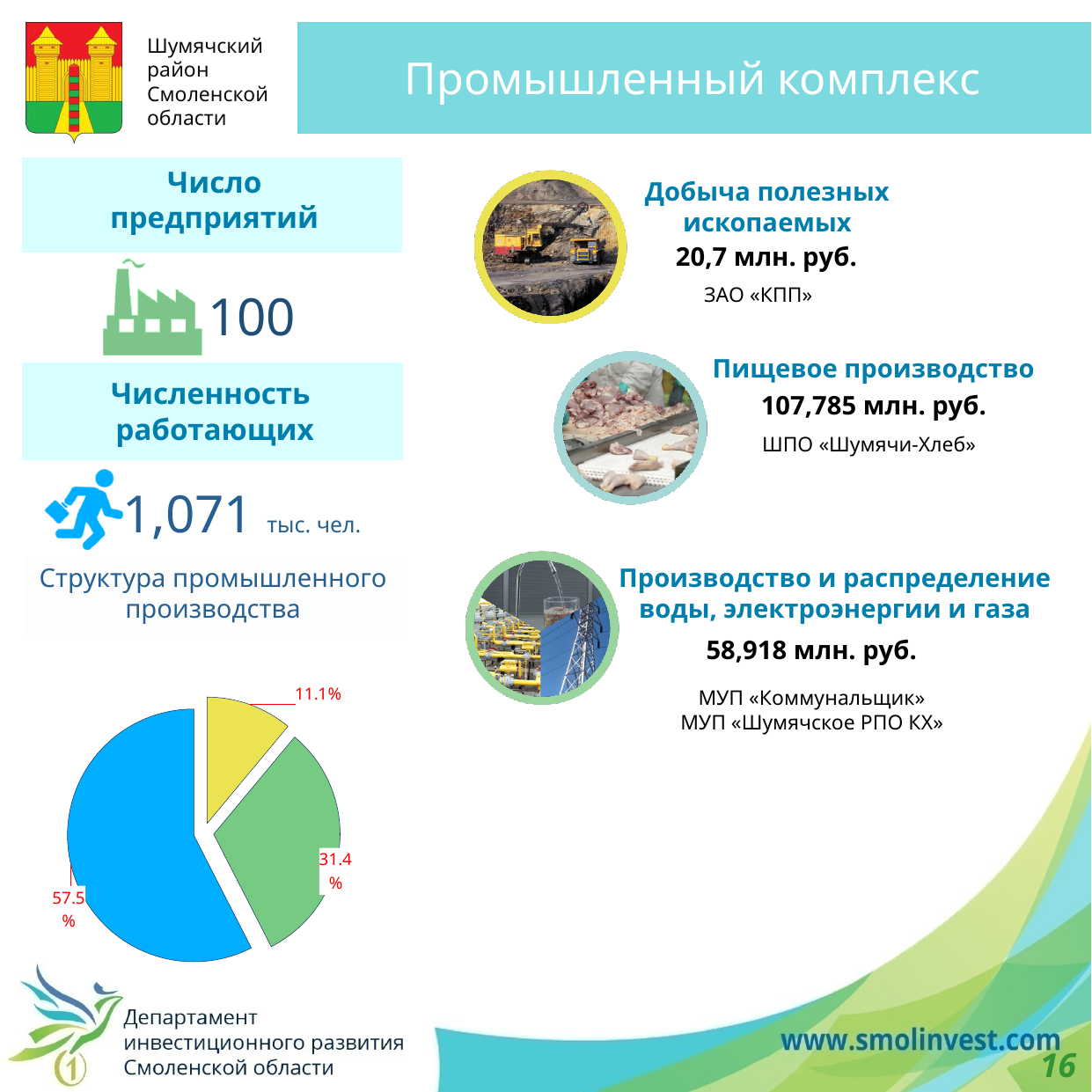
What is the value of the largest slice in the pie chart "Структура промышленного производства"? 57.5% What is the value of the smallest slice in the pie chart "Структура промышленного производства"? 11.1% In the pie chart "Структура промышленного производства", what share does the middle-sized slice represent? 31.4% How many slices does the pie chart "Структура промышленного производства" have? 3 In the pie chart "Структура промышленного производства", is the largest slice greater or less than 50%? greater What colour is the largest slice of the pie chart "Структура промышленного производства"? blue What is the title shown above the pie chart on the slide? Структура промышленного производства In the pie chart "Структура промышленного производства", which is larger: the green slice or the yellow slice? the green slice In the pie chart "Структура промышленного производства", what is the difference between the largest slice and the smallest slice? 46.4% What kind of chart is shown under "Структура промышленного производства"? pie chart In the pie chart "Структура промышленного производства", what is the difference between the 57.5% slice and the 31.4% slice? 26.1%